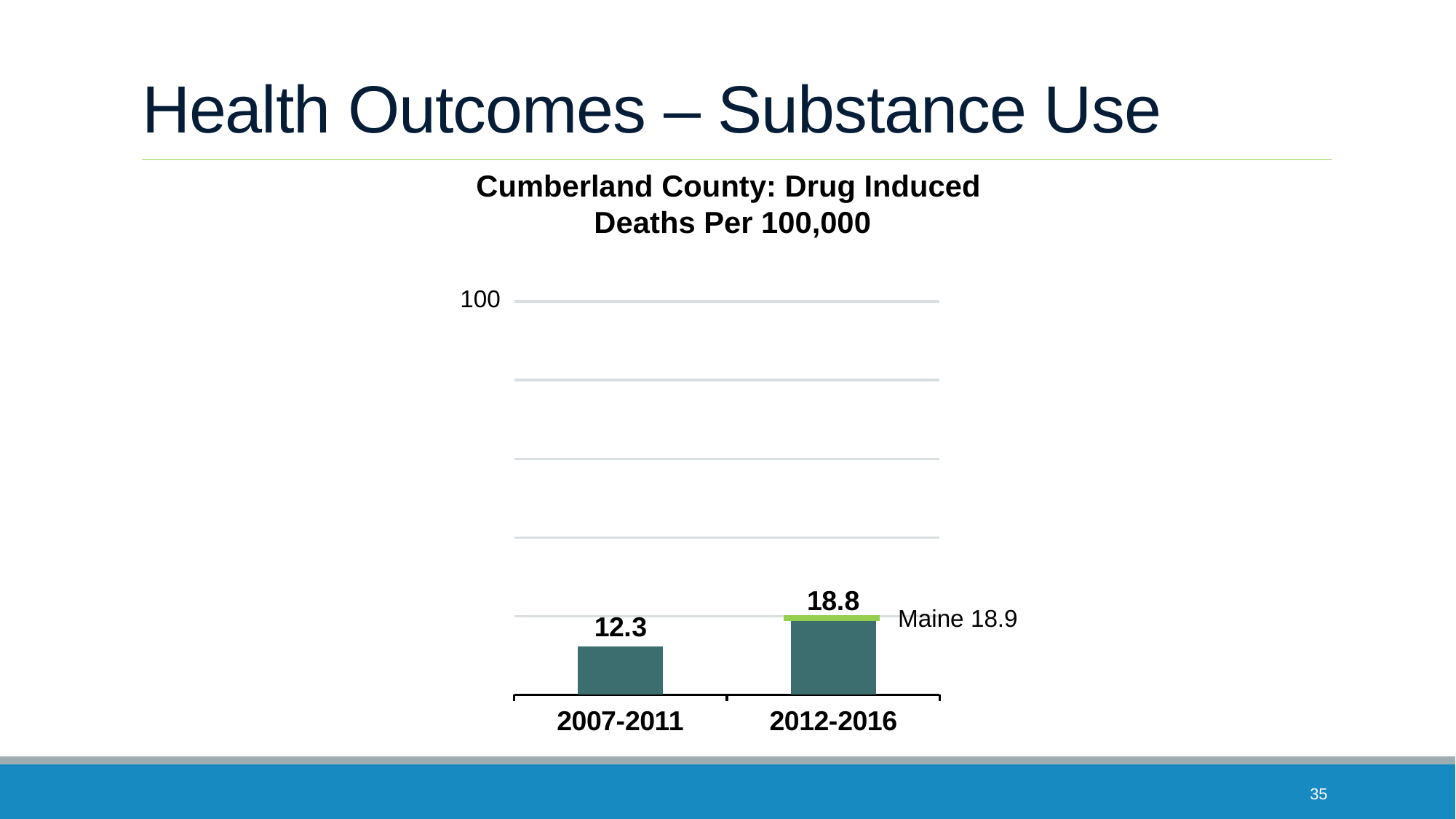
What is the difference between the values for 2012-2016 and 2007-2011? 6.5 What is the value for 2012-2016? 18.8 Do the values rise or fall from 2007-2011 to 2012-2016? rise What Maine value is marked on the chart? 18.9 Is the value for 2012-2016 greater or less than 100? less Which period has the highest value? 2012-2016 Which period has the lowest value? 2007-2011 What kind of chart is shown? bar chart What is the title of the chart? Cumberland County: Drug Induced Deaths Per 100,000 What is the value for 2007-2011? 12.3 Which is larger, the value for 2007-2011 or the value for 2012-2016? 2012-2016 How many time periods are shown on the x axis? 2